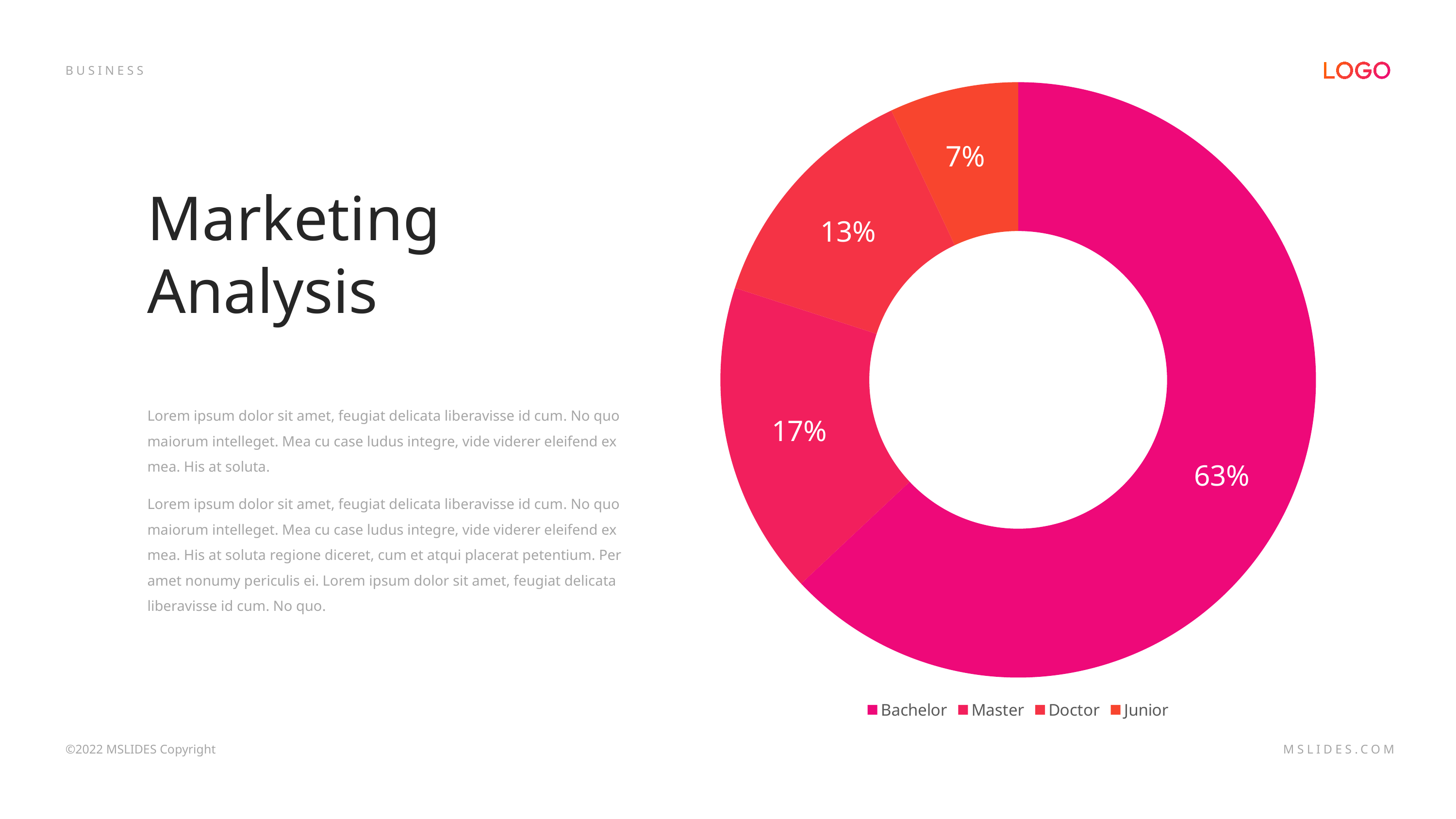
How many categories are shown in the doughnut chart? 4 What percentage of the doughnut chart does Junior represent? 7% Which category has the smallest share of the doughnut chart? Junior Which category has the largest share of the doughnut chart? Bachelor What percentage of the doughnut chart does Doctor represent? 13% What percentage of the doughnut chart does Bachelor represent? 63% Which has a larger share, Master or Doctor? Master What is the difference in percentage points between the Doctor and Junior shares? 6 What type of chart is shown on the slide? Doughnut chart Which category is shown in orange in the legend? Junior What percentage of the doughnut chart does Master represent? 17% What is the difference in percentage points between the Bachelor and Master shares? 46